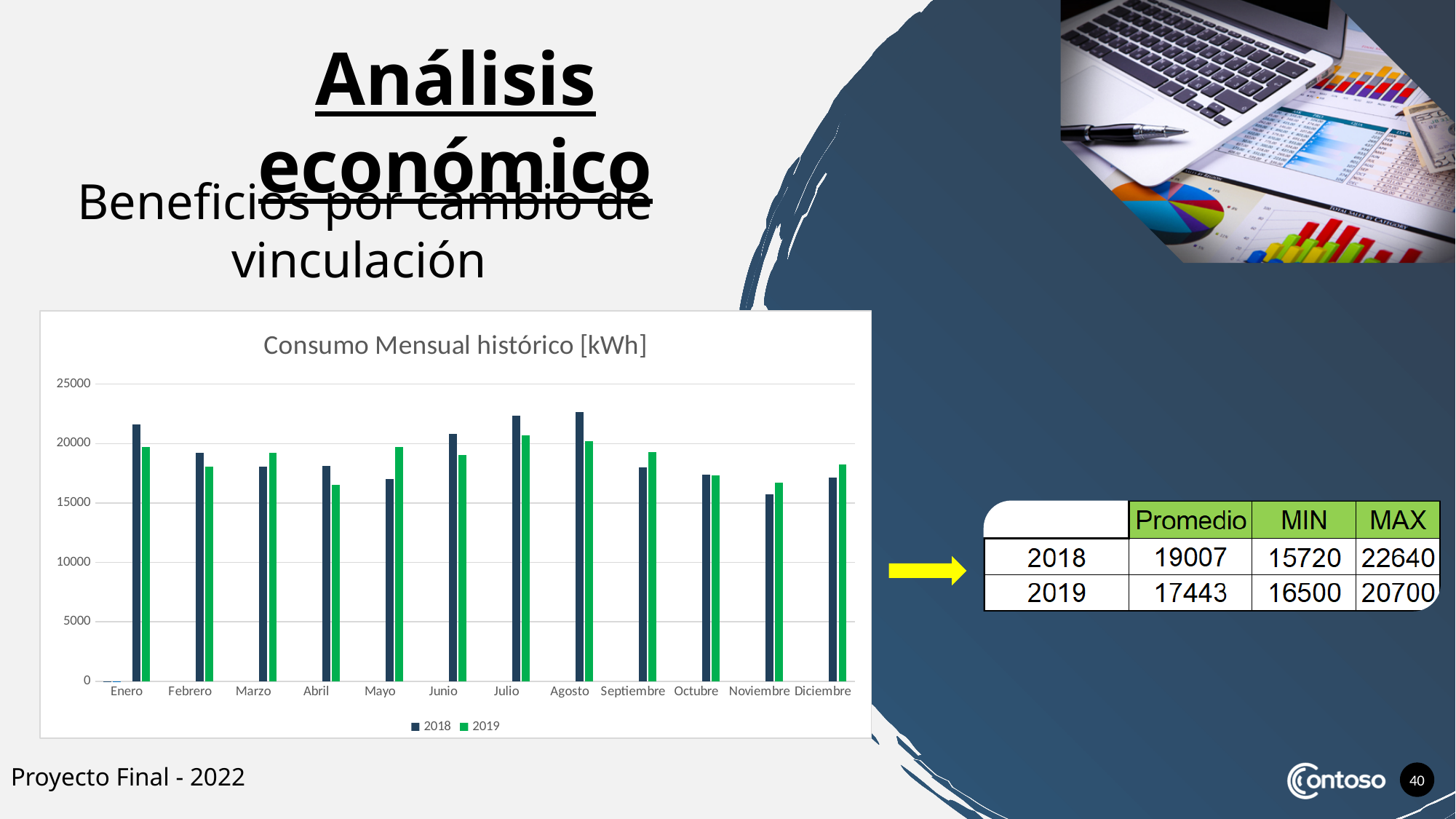
Is the 2019 value for Abril greater or less than 20000? less What is the title of the chart? Consumo Mensual histórico [kWh] What type of chart is shown on the slide? bar chart In Mayo, which series has the larger value, 2018 or 2019? 2019 Is the 2018 value for Enero greater or less than 20000? greater In which month is the 2018 bar the lowest? Noviembre In which month is the 2019 bar the highest? Julio In which month is the 2019 bar the lowest? Abril How many series does the chart legend list? 2 How many months are shown on the x axis of the chart? 12 Which series are listed in the chart legend? 2018 and 2019 In which month is the 2018 bar the highest? Agosto